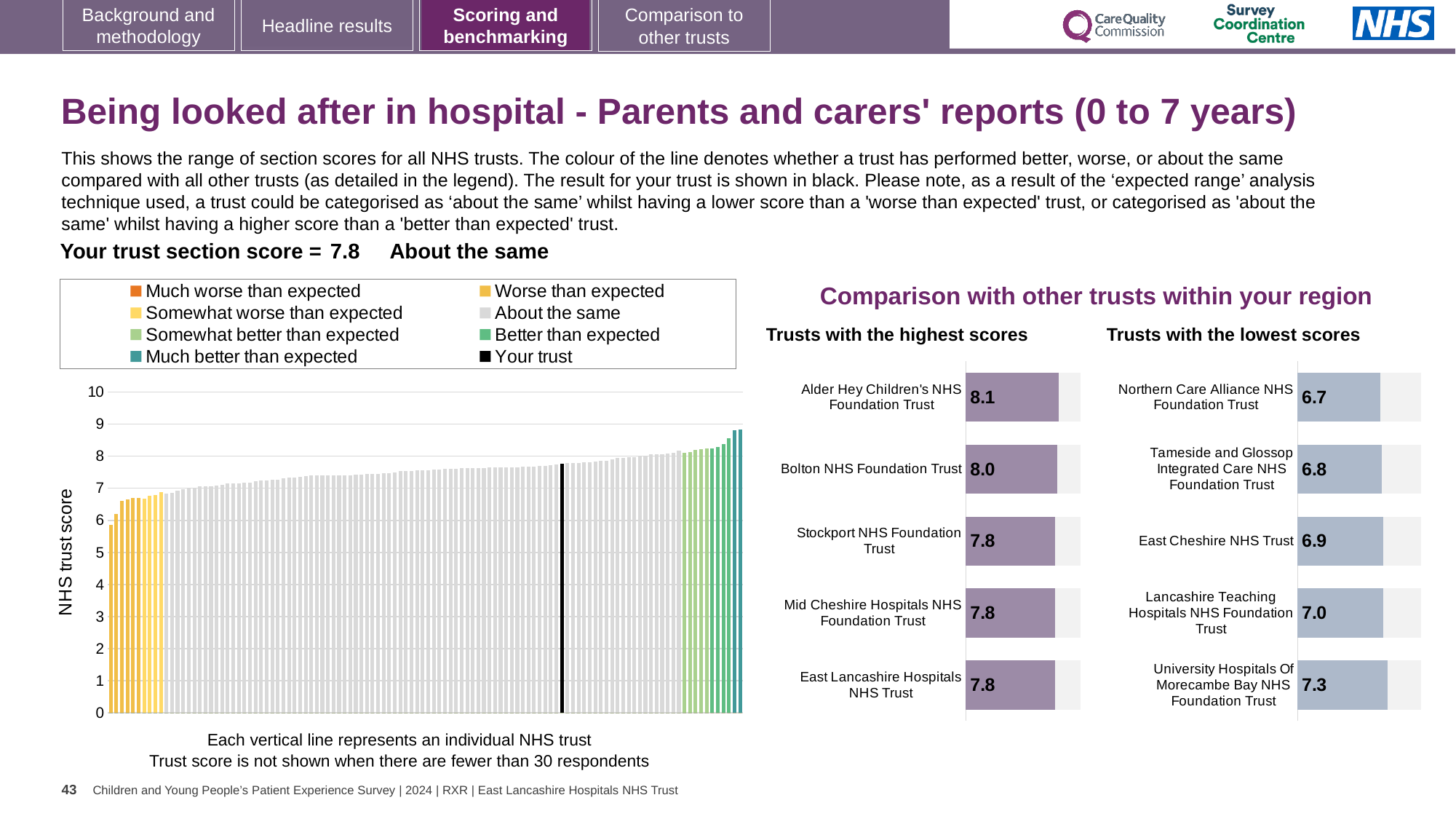
In the 'Trusts with the lowest scores' chart, which trust has the highest score? University Hospitals Of Morecambe Bay NHS Foundation Trust In the 'Trusts with the highest scores' chart, what is the difference between the scores of Alder Hey Children's NHS Foundation Trust and Stockport NHS Foundation Trust? 0.3 In the 'Trusts with the lowest scores' chart, what is the difference between the scores of University Hospitals Of Morecambe Bay NHS Foundation Trust and Northern Care Alliance NHS Foundation Trust? 0.6 In the large chart on the left showing all NHS trusts, is the value for the black bar (your trust) greater or less than 7? greater In the 'Trusts with the lowest scores' chart, what is the score for Northern Care Alliance NHS Foundation Trust? 6.7 What kind of chart is the large chart on the left with the 'NHS trust score' axis? bar chart In the 'Trusts with the highest scores' chart, which trust has the highest score? Alder Hey Children's NHS Foundation Trust In the 'Trusts with the highest scores' chart, what is the score for Alder Hey Children's NHS Foundation Trust? 8.1 In the 'Trusts with the highest scores' chart, what is the score for Bolton NHS Foundation Trust? 8.0 In the 'Trusts with the lowest scores' chart, which trust has the lowest score? Northern Care Alliance NHS Foundation Trust How many trusts are shown in the 'Trusts with the lowest scores' chart? 5 In the 'Trusts with the lowest scores' chart, which has the larger score: Tameside and Glossop Integrated Care NHS Foundation Trust or East Cheshire NHS Trust? East Cheshire NHS Trust